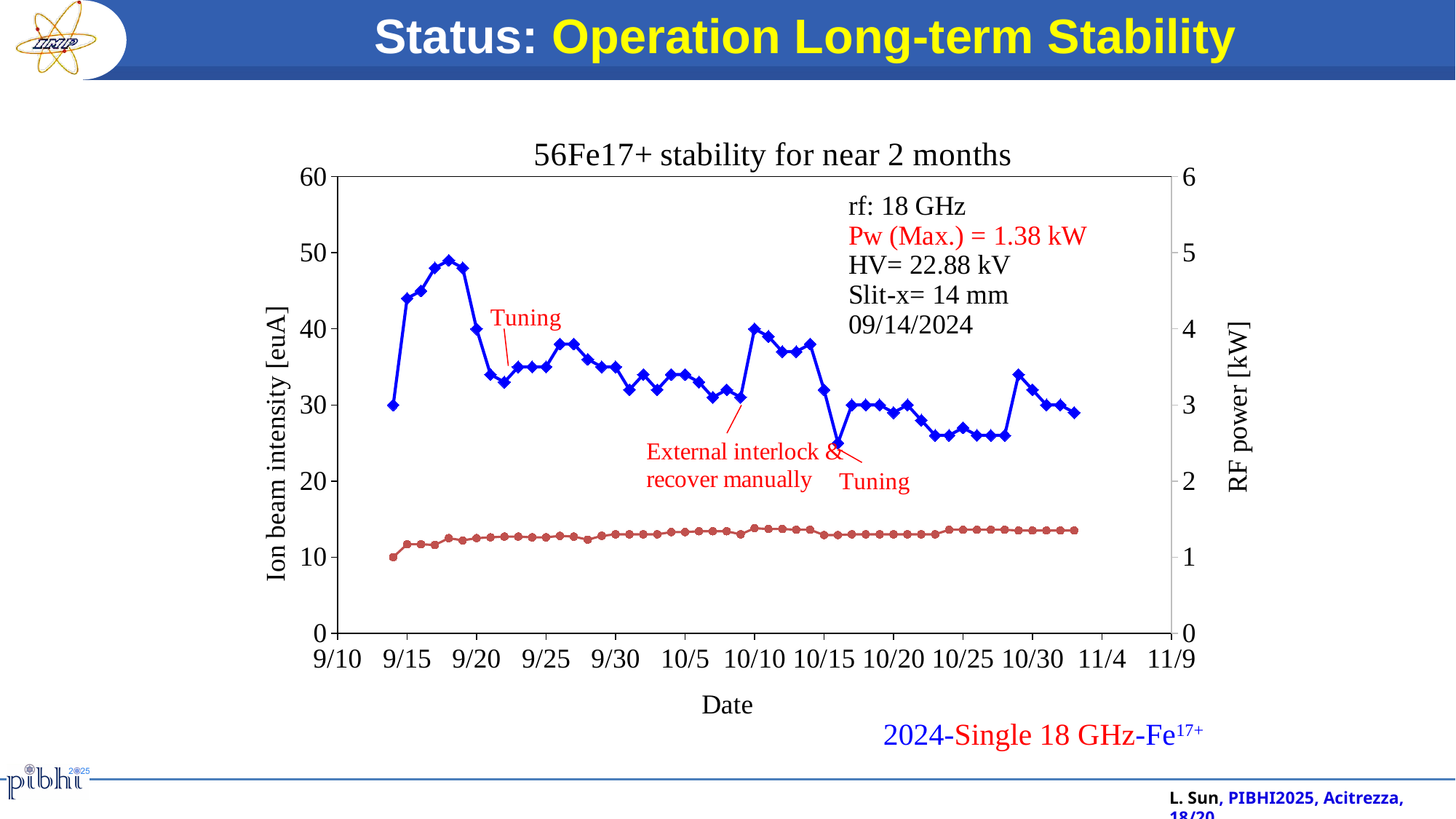
Is the peak ion beam intensity (around 9/18) greater or less than 40 euA? greater How many data series are plotted on the chart? 2 Does the ion beam intensity rise or fall between 10/10 and 10/16? fall What maximum RF power is stated in the text box on the chart? 1.38 kW What is the label of the left vertical axis? Ion beam intensity [euA] Is the lowest ion beam intensity (around 10/16) greater or less than 30 euA? less What kind of chart is shown on the slide? line chart What is the title of the chart? 56Fe17+ stability for near 2 months Is the RF power around 10/30 greater or less than 1 kW? greater Which is larger, the ion beam intensity around 9/18 or around 10/10? around 9/18 Does the ion beam intensity rise or fall between 9/14 and 9/18? rise